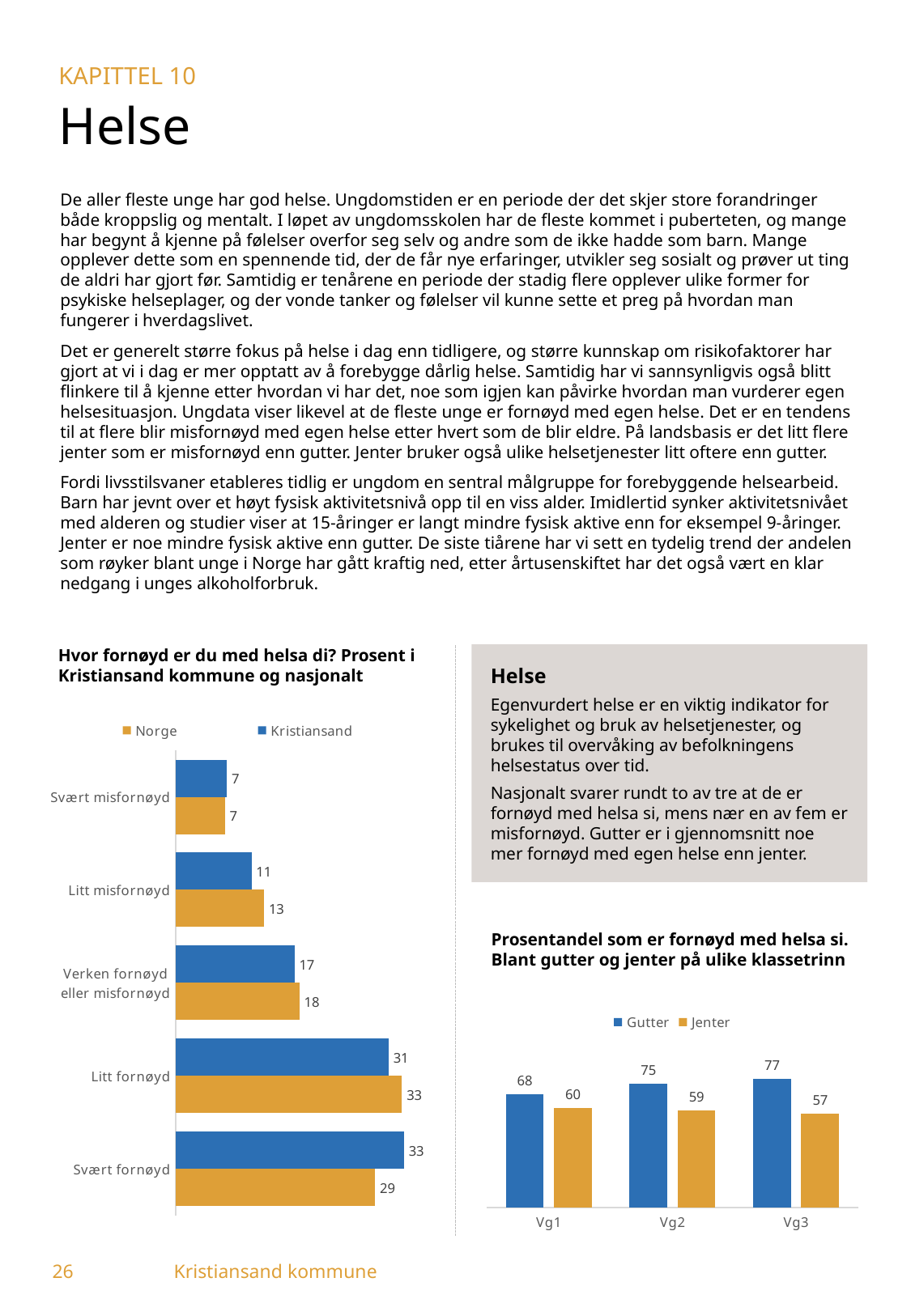
In the chart 'Hvor fornøyd er du med helsa di?', which is larger in the 'Litt misfornøyd' category, Norge or Kristiansand? Norge In the chart 'Hvor fornøyd er du med helsa di?', how many series does the legend list? 2 In the chart 'Hvor fornøyd er du med helsa di?', what is the difference between Norge and Kristiansand in the 'Svært fornøyd' category? 4 In the chart 'Prosentandel som er fornøyd med helsa si', what is the difference between Gutter and Jenter at Vg3? 20 In the chart 'Prosentandel som er fornøyd med helsa si', what is the value for Jenter at Vg2? 59 In the chart 'Hvor fornøyd er du med helsa di?', what is the value for Kristiansand in the 'Litt fornøyd' category? 31 What kind of chart is 'Hvor fornøyd er du med helsa di?'? Bar chart In the chart 'Prosentandel som er fornøyd med helsa si', do the values for Jenter rise or fall from Vg1 to Vg3? Fall In the chart 'Hvor fornøyd er du med helsa di?', which category has the highest value for Norge? Litt fornøyd In the chart 'Hvor fornøyd er du med helsa di?', how many categories are shown? 5 In the chart 'Hvor fornøyd er du med helsa di?', what is the value for Norge in the 'Svært fornøyd' category? 29 In the chart 'Prosentandel som er fornøyd med helsa si', which class level has the highest value for Gutter? Vg3